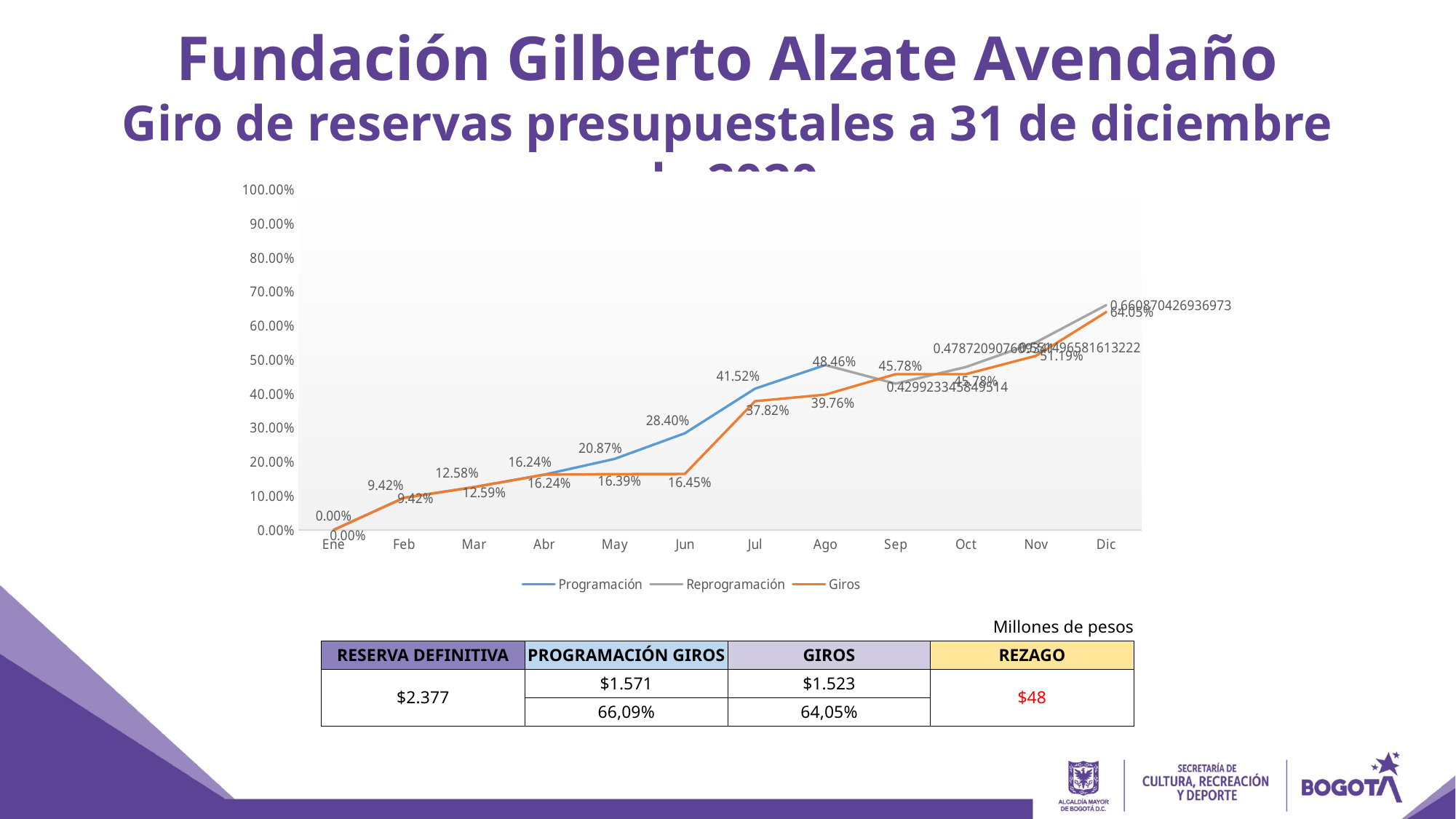
What type of chart is shown on the slide? Line chart What is the Programación value for Ago? 48.46% How many series does the chart legend list? 3 What is the Giros value for Jul? 37.82% Does the Giros series rise or fall from Ene to Dic? Rise In which month is the Giros series at its highest? Dic What is the difference between the Programación and Giros values for Jul? 3.70% Is the Giros value for Nov greater or less than 40%? greater Which is larger in Ago, the Programación value or the Giros value? Programación What is the Giros value for Dic? 64.05% How many months are shown on the x axis of the chart? 12 What is the Programación value for Jun? 28.40%